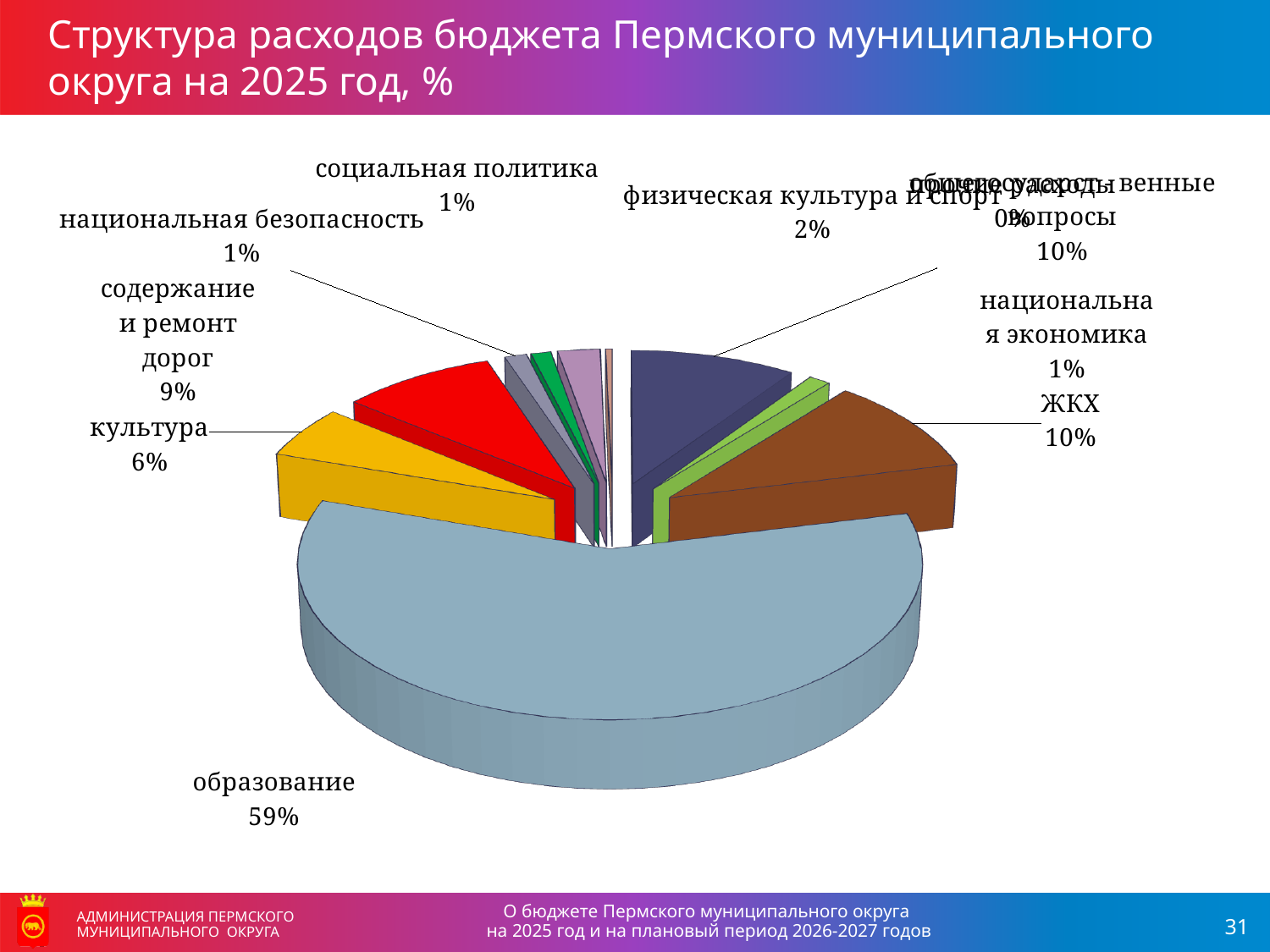
Which category has the largest share of the pie? образование What type of chart is shown on the slide? Pie chart What is the value shown for национальная безопасность? 1% What share of the budget expenditure goes to образование? 59% By how many percentage points does образование exceed ЖКХ? 49 Which is larger: культура or содержание и ремонт дорог? содержание и ремонт дорог What is the value shown for физическая культура и спорт? 2% What is the title of the chart on the slide? Структура расходов бюджета Пермского муниципального округа на 2025 год, % By how many percentage points does содержание и ремонт дорог exceed культура? 3 What is the value shown for ЖКХ? 10% What is the value shown for содержание и ремонт дорог? 9% What is the value shown for культура? 6%